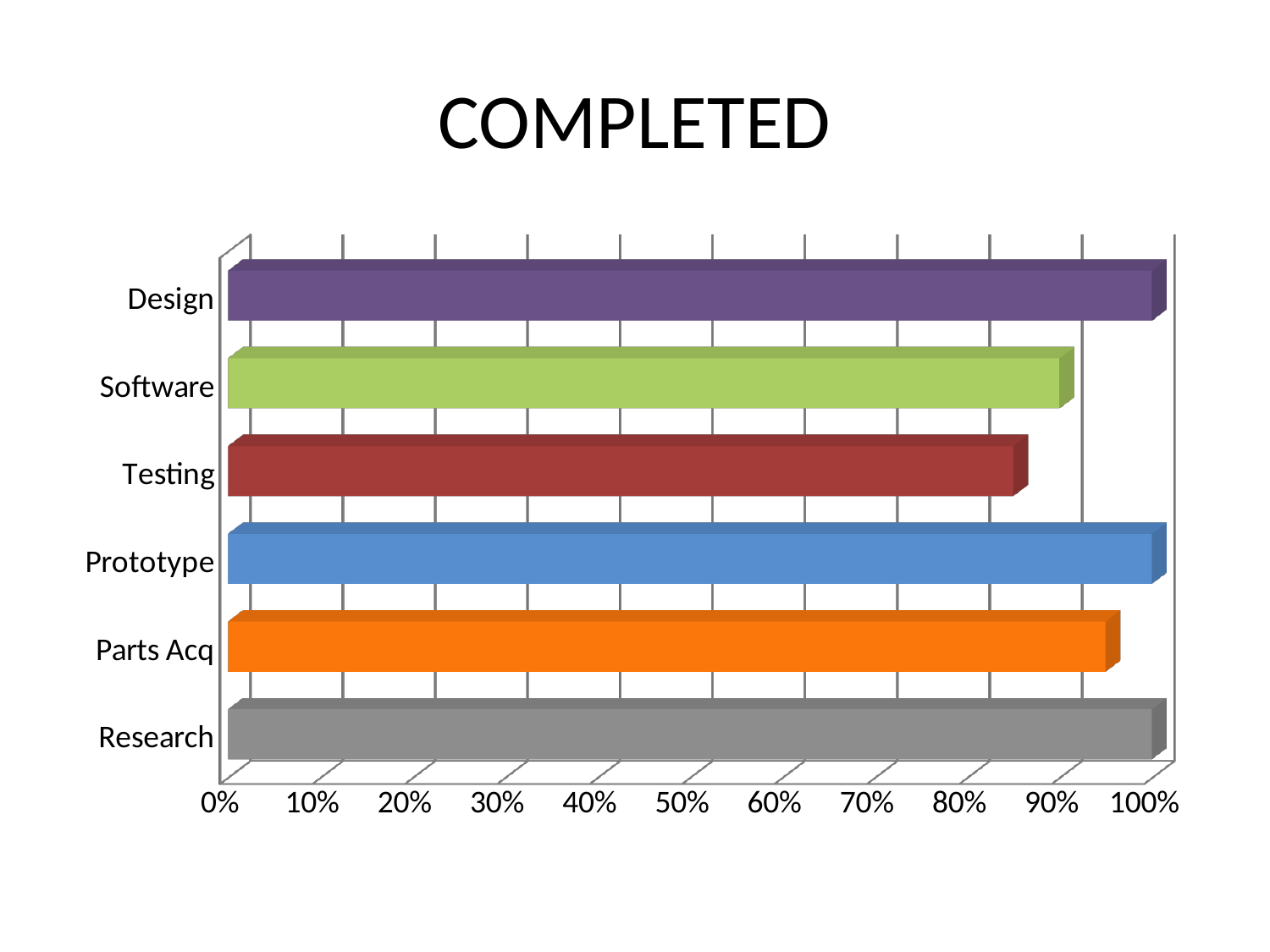
Which is larger, the value for Parts Acq or the value for Testing? Parts Acq What kind of chart is shown on the slide? bar chart Is the value for Testing greater or less than 80%? greater Is the value for Parts Acq greater or less than 90%? greater Is the value for Design greater or less than 90%? greater What is the title of the chart? COMPLETED What colour is the bar for Testing? dark red Which category has the lowest value? Testing How many categories are plotted in the chart? 6 Which is larger, the value for Software or the value for Testing? Software